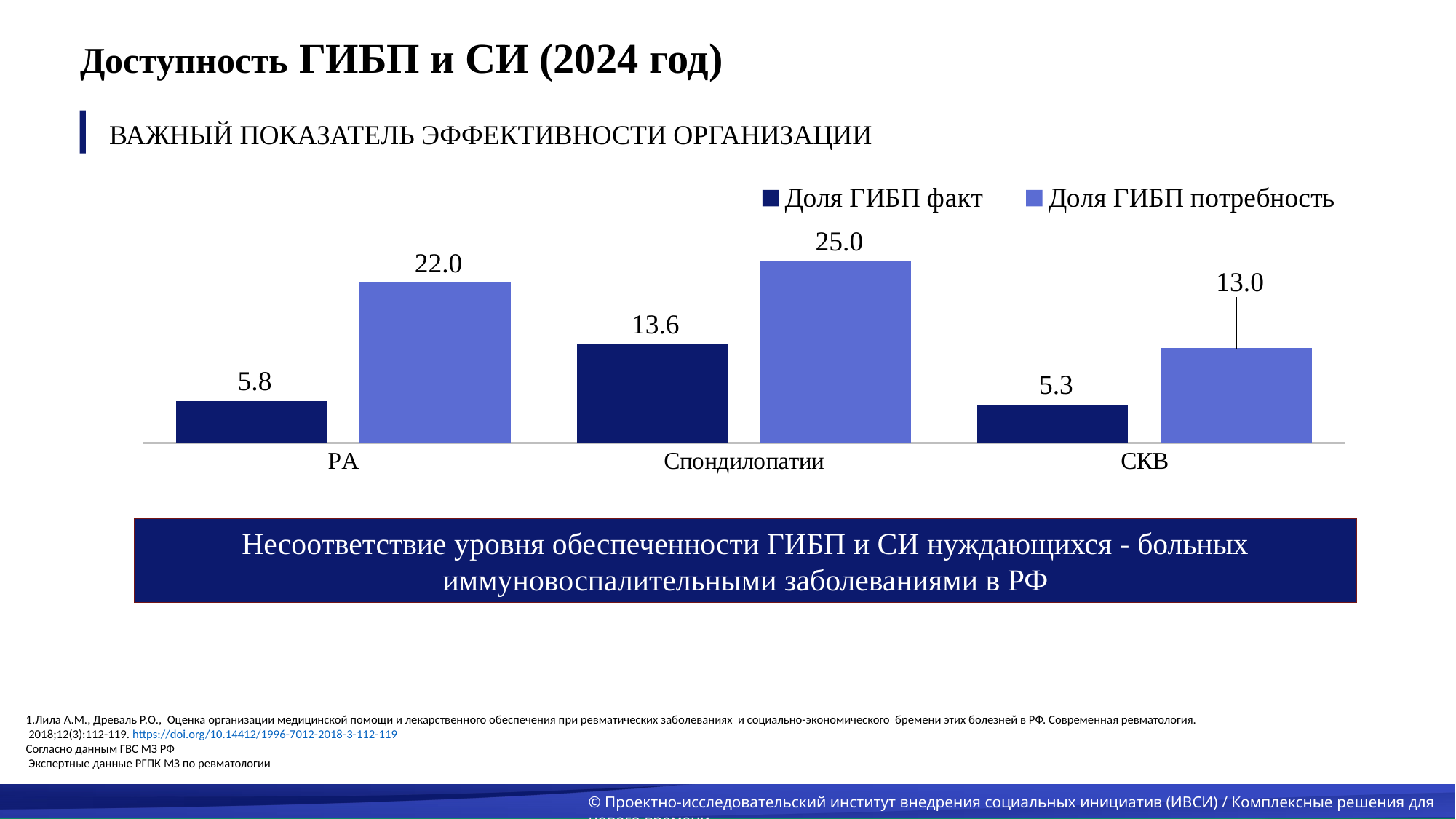
What kind of chart is shown on the slide? Bar chart Which category has the highest Доля ГИБП потребность value? Спондилопатии What is the value of Доля ГИБП факт for РА? 5.8 What are the two series named in the legend? Доля ГИБП факт and Доля ГИБП потребность What is the difference between Доля ГИБП потребность and Доля ГИБП факт for РА? 16.2 How many categories are shown on the x axis of the chart? 3 What is the value of Доля ГИБП факт for Спондилопатии? 13.6 What is the value of Доля ГИБП потребность for СКВ? 13.0 Which is larger for СКВ: Доля ГИБП факт or Доля ГИБП потребность? Доля ГИБП потребность Which category has the lowest Доля ГИБП факт value? СКВ How many series does the legend list? 2 What is the value of Доля ГИБП потребность for Спондилопатии? 25.0